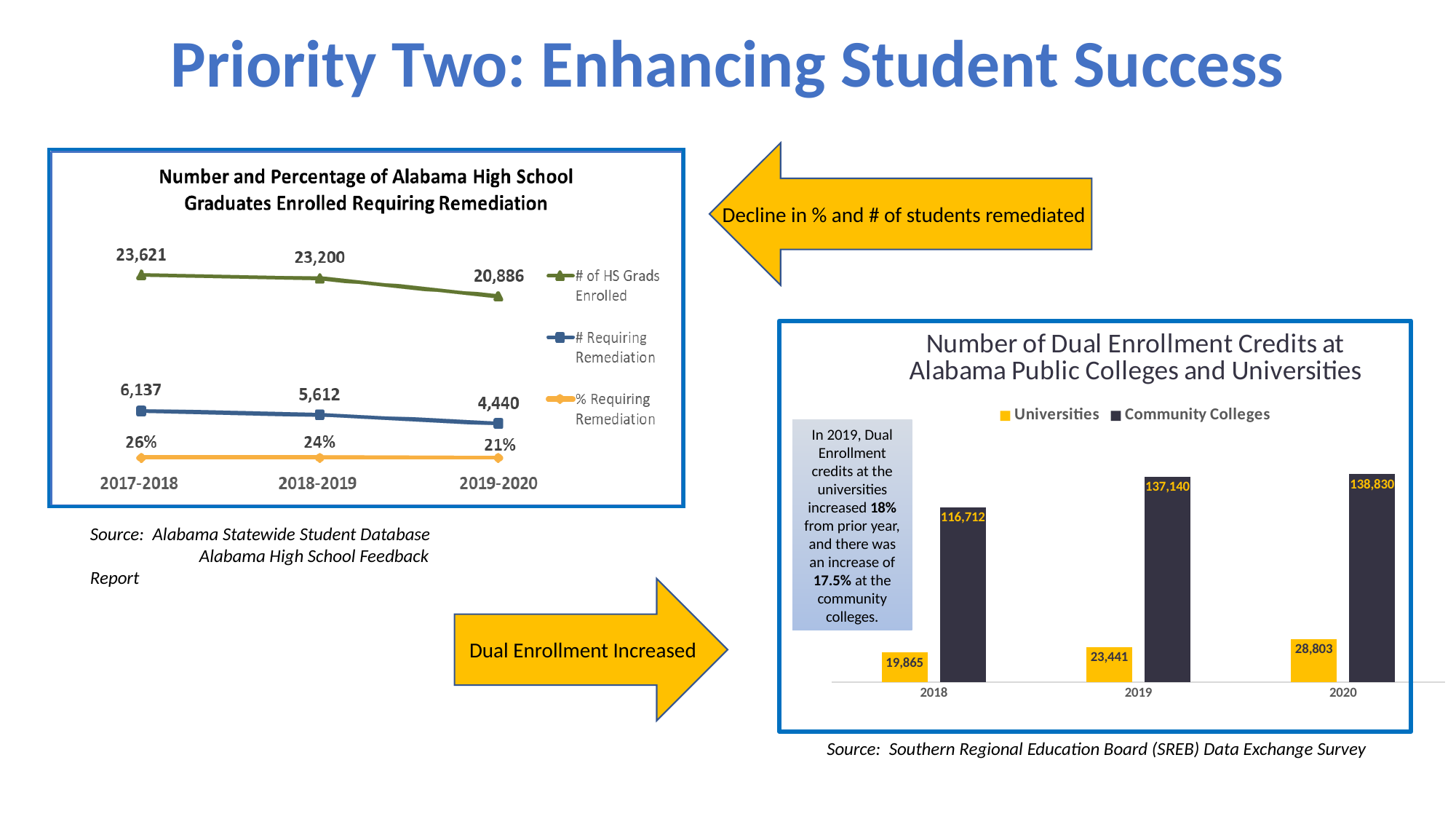
What kind of chart is the 'Number of Dual Enrollment Credits at Alabama Public Colleges and Universities' chart? bar chart What kind of chart is the 'Number and Percentage of Alabama High School Graduates Enrolled Requiring Remediation' chart? line chart In the 'Number of Dual Enrollment Credits at Alabama Public Colleges and Universities' chart, what is the value for Universities in 2019? 23,441 In the 'Number and Percentage of Alabama High School Graduates Enrolled Requiring Remediation' chart, how many series does the legend list? 3 In the 'Number and Percentage of Alabama High School Graduates Enrolled Requiring Remediation' chart, what is the number of HS grads enrolled in 2017-2018? 23,621 In the 'Number and Percentage of Alabama High School Graduates Enrolled Requiring Remediation' chart, what is the difference between the number of HS grads enrolled in 2017-2018 and 2019-2020? 2,735 In the 'Number and Percentage of Alabama High School Graduates Enrolled Requiring Remediation' chart, what is the % requiring remediation in 2018-2019? 24% In the 'Number of Dual Enrollment Credits at Alabama Public Colleges and Universities' chart, what is the difference between Universities credits in 2020 and 2019? 5,362 In the 'Number and Percentage of Alabama High School Graduates Enrolled Requiring Remediation' chart, does the number requiring remediation rise or fall from 2017-2018 to 2019-2020? fall In the 'Number of Dual Enrollment Credits at Alabama Public Colleges and Universities' chart, what is the value for Community Colleges in 2018? 116,712 In the 'Number of Dual Enrollment Credits at Alabama Public Colleges and Universities' chart, which year has the highest value for Community Colleges? 2020 In the 'Number and Percentage of Alabama High School Graduates Enrolled Requiring Remediation' chart, what is the number requiring remediation in 2019-2020? 4,440